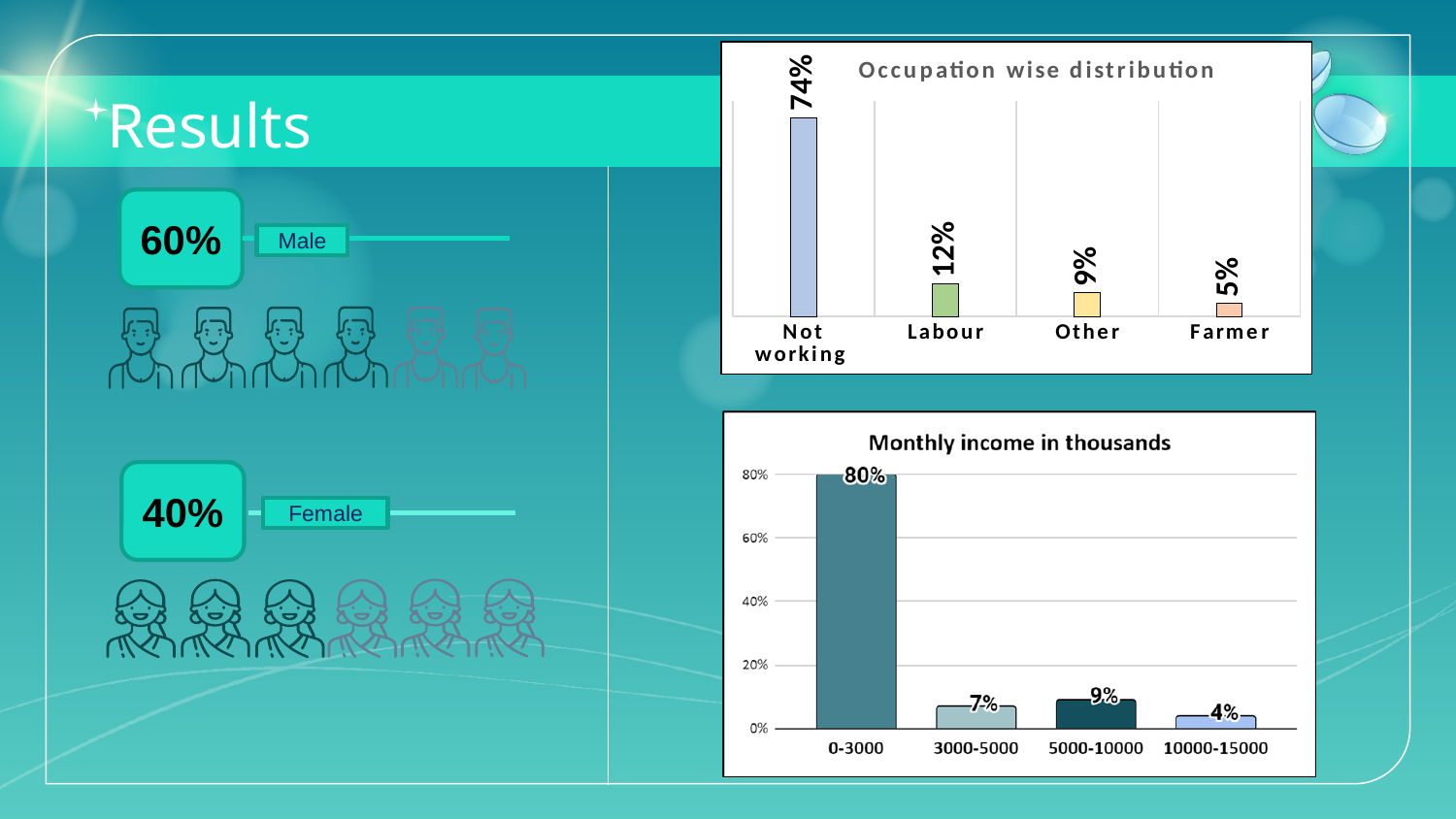
In the 'Occupation wise distribution' chart, which is larger, Other or Farmer? Other In the 'Occupation wise distribution' chart, what is the value for Labour? 12% In the 'Monthly income in thousands' chart, what is the value for 5000-10000? 9% In the 'Monthly income in thousands' chart, which category has the highest value? 0-3000 In the 'Occupation wise distribution' chart, what is the difference between Labour and Other? 3% In the 'Monthly income in thousands' chart, which category has the lowest value? 10000-15000 In the 'Occupation wise distribution' chart, what is the value for Not working? 74% What kind of chart is the 'Monthly income in thousands' chart? Bar chart In the 'Occupation wise distribution' chart, which category has the lowest value? Farmer In the 'Monthly income in thousands' chart, what is the difference between 0-3000 and 3000-5000? 73% In the 'Occupation wise distribution' chart, how many categories are shown? 4 In the 'Monthly income in thousands' chart, what is the value for 0-3000? 80%